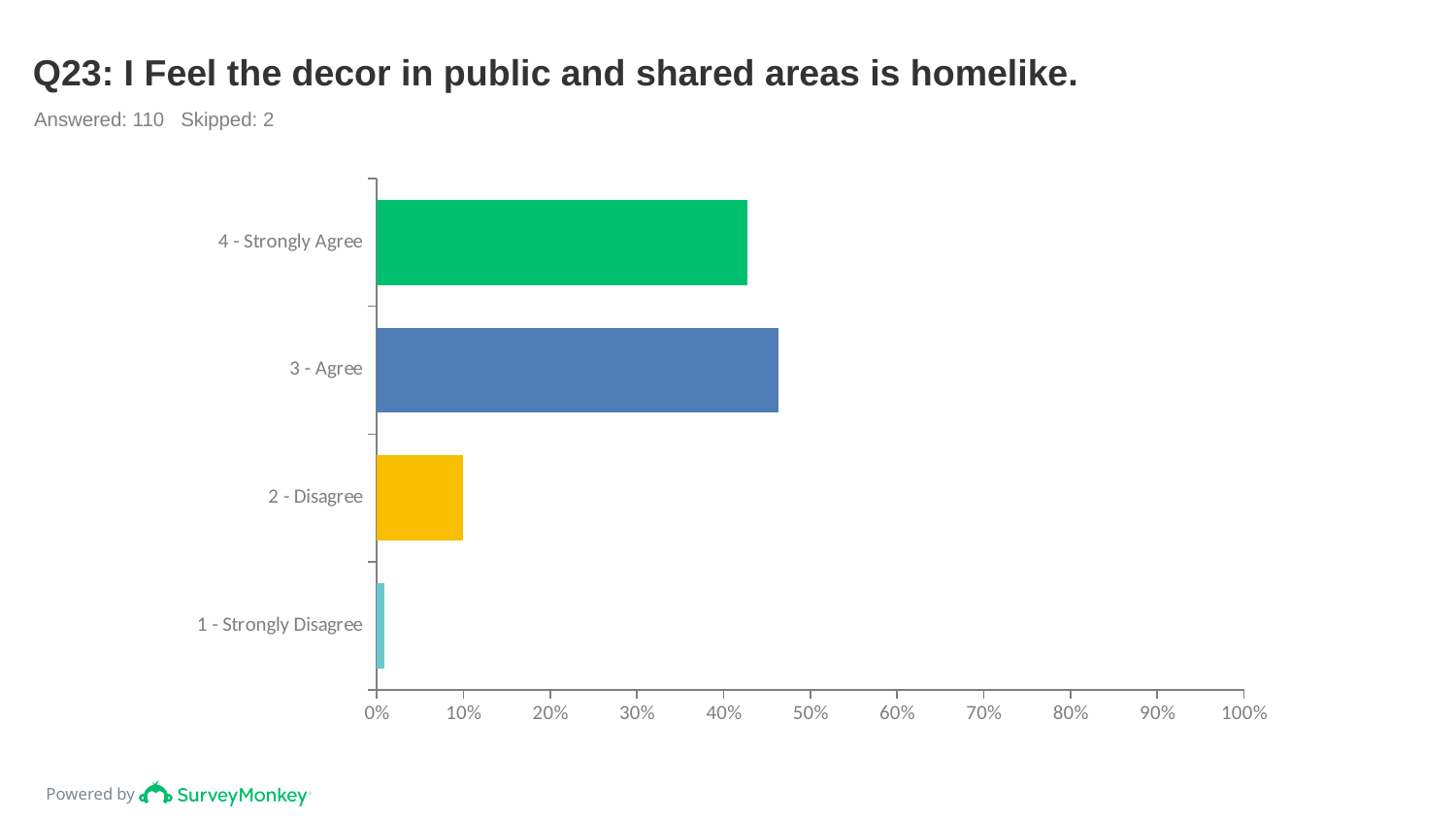
What kind of chart is shown on the slide? bar chart Which response category has the highest value? 3 - Agree Is the value for 1 - Strongly Disagree greater or less than 10%? less Is the value for 4 - Strongly Agree greater or less than 40%? greater What is the title of the chart? Q23: I Feel the decor in public and shared areas is homelike. How many respondents answered this question according to the slide? 110 Which is larger, the value for 3 - Agree or the value for 2 - Disagree? 3 - Agree How many response categories are shown in the chart? 4 Is the value for 3 - Agree greater or less than 50%? less Which response category has the lowest value? 1 - Strongly Disagree Which is larger, the value for 2 - Disagree or the value for 1 - Strongly Disagree? 2 - Disagree